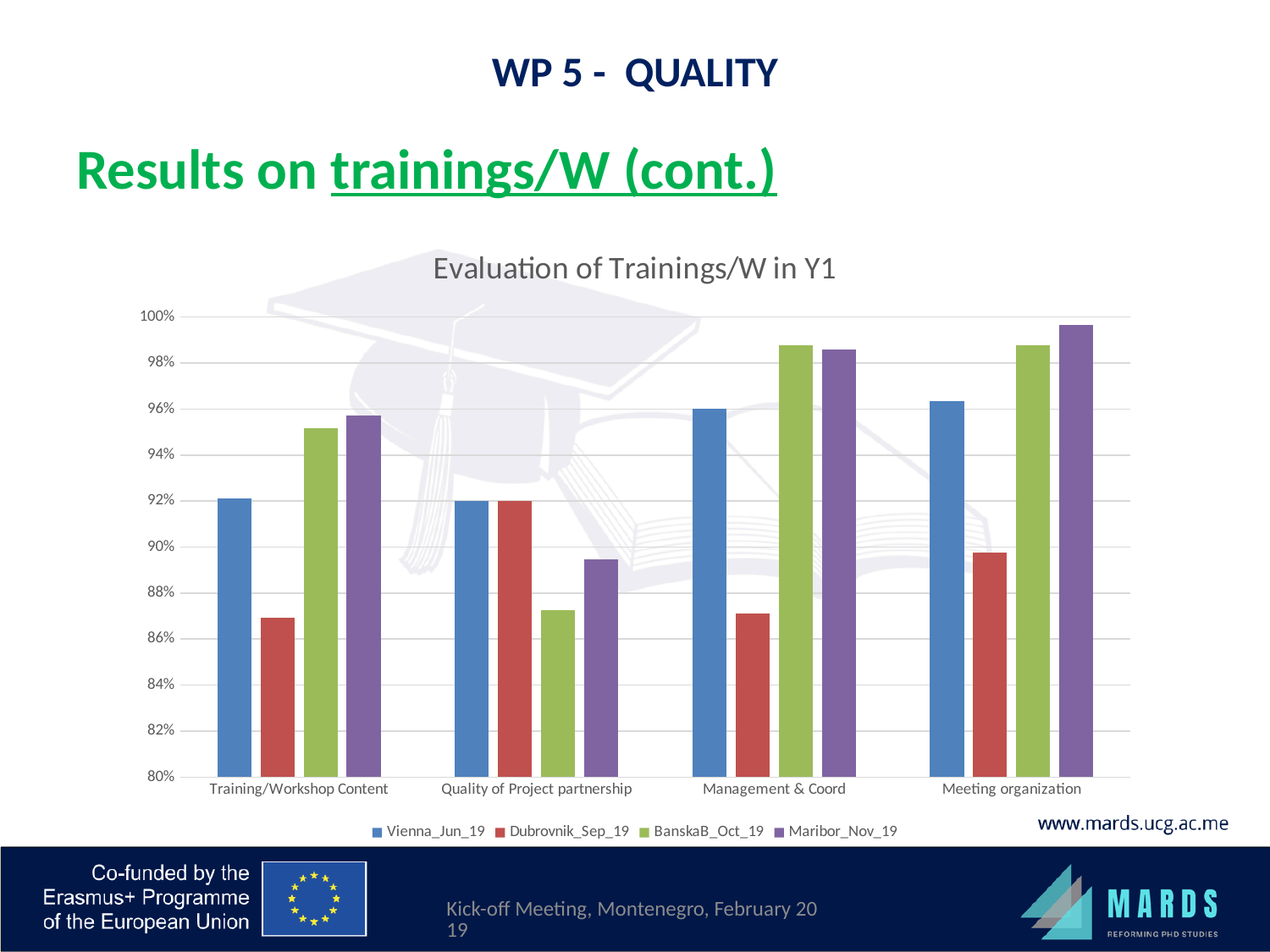
What is the title of the chart? Evaluation of Trainings/W in Y1 Which series has the lowest value for Training/Workshop Content? Dubrovnik_Sep_19 Is the value for Maribor_Nov_19 in Meeting organization greater or less than 98%? greater Is the value for Dubrovnik_Sep_19 in Training/Workshop Content greater or less than 88%? less Is the value for Vienna_Jun_19 in Training/Workshop Content greater or less than 90%? greater Which series has the highest value for Meeting organization? Maribor_Nov_19 For Quality of Project partnership, which is larger: Dubrovnik_Sep_19 or Maribor_Nov_19? Dubrovnik_Sep_19 Which series has the lowest value for Quality of Project partnership? BanskaB_Oct_19 How many series does the legend list? 4 Which series has the lowest value for Management & Coord? Dubrovnik_Sep_19 How many categories are shown on the x axis? 4 What kind of chart is shown on the slide? Bar chart